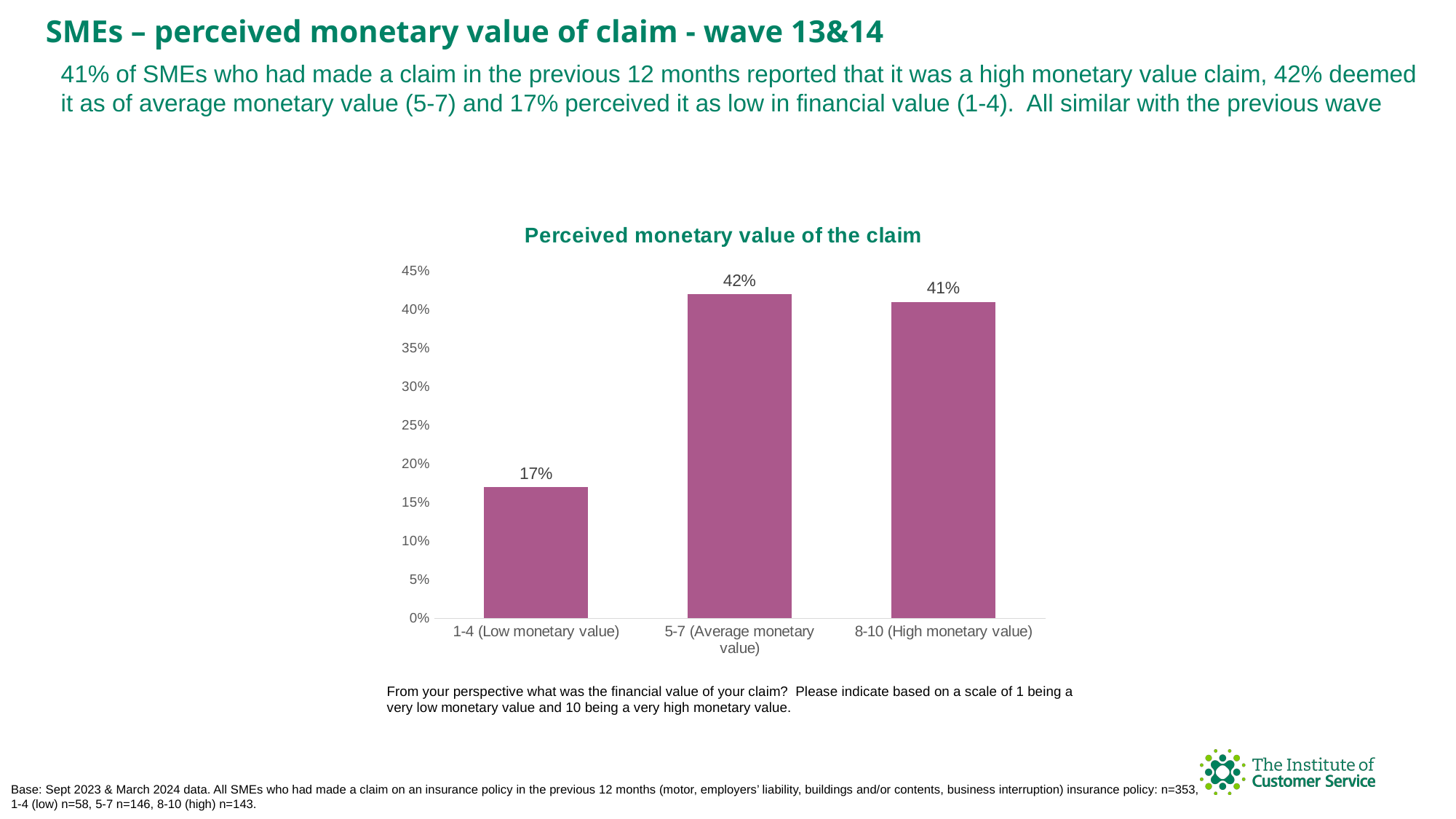
What kind of chart is shown on the slide? Bar chart What percentage of SMEs rated their claim as 1-4 (Low monetary value)? 17% Which category has the lowest value? 1-4 (Low monetary value) What is the difference between the values for 5-7 (Average monetary value) and 1-4 (Low monetary value)? 25 percentage points What is the title of the chart? Perceived monetary value of the claim What is the difference between the values for 8-10 (High monetary value) and 1-4 (Low monetary value)? 24 percentage points Which is larger: the value for 1-4 (Low monetary value) or 8-10 (High monetary value)? 8-10 (High monetary value) Which category has the highest value? 5-7 (Average monetary value) What is the value shown for 8-10 (High monetary value)? 41% What is the value shown for 5-7 (Average monetary value)? 42% Is the value for 1-4 (Low monetary value) greater or less than 20%? less How many categories are shown on the x axis? 3